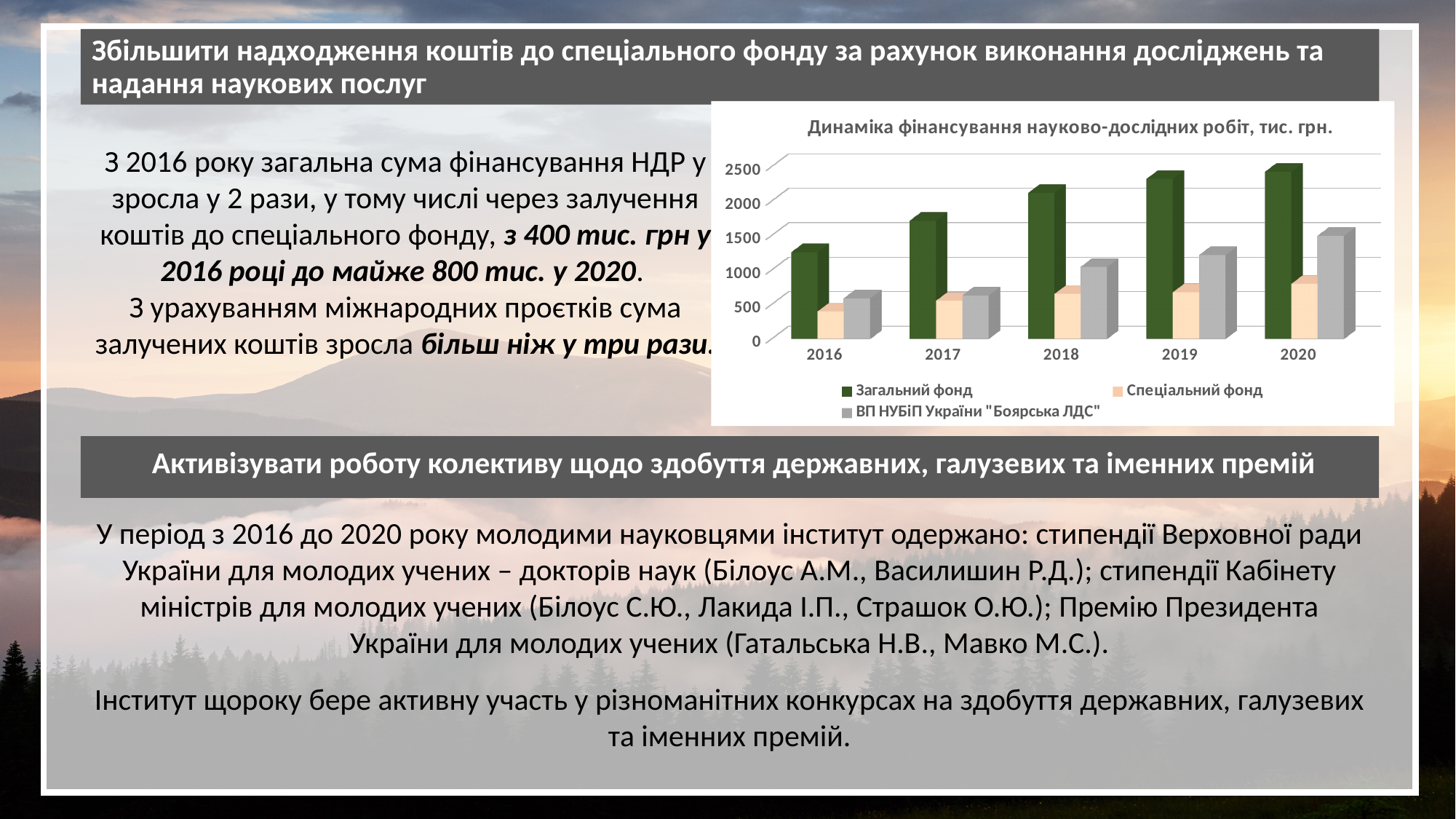
Is the value for Загальний фонд in 2018 greater or less than 2000? greater Is the value for Спеціальний фонд in 2016 greater or less than 500? less Do the values for Загальний фонд rise or fall from 2016 to 2020? rise What is the title of the chart? Динаміка фінансування науково-дослідних робіт, тис. грн. In which year is the value for Загальний фонд highest? 2020 In 2019, which is larger: the value for Загальний фонд or the value for ВП НУБіП України "Боярська ЛДС"? Загальний фонд How many series does the chart legend list? 3 What kind of chart is shown on the slide? bar chart Is the value for ВП НУБіП України "Боярська ЛДС" in 2020 greater or less than 1000? greater How many years are shown on the x axis of the chart? 5 In which year is the value for Загальний фонд lowest? 2016 Which series is shown in green in the chart? Загальний фонд